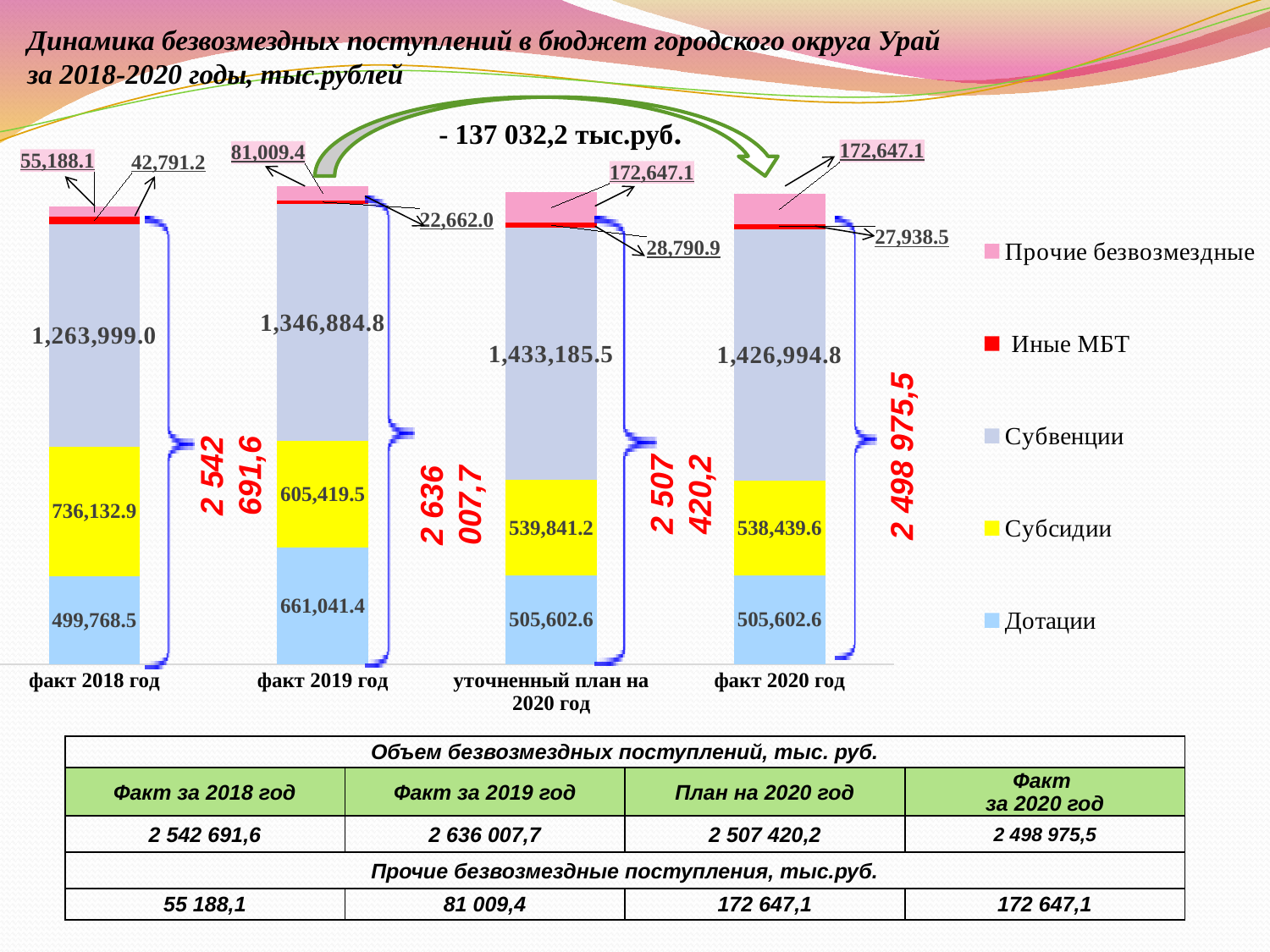
How many series does the chart legend list? 5 What kind of chart is shown on the slide? Stacked bar chart What is the value of Прочие безвозмездные for факт 2019 год? 81,009.4 How many categories (bars) are shown on the x axis of the chart? 4 Which is larger: Дотации for факт 2019 год or Дотации for факт 2018 год? факт 2019 год Which category has the lowest value for Иные МБТ? факт 2019 год What is the value of Субсидии for факт 2020 год? 538,439.6 What is the value of Субвенции for факт 2019 год? 1,346,884.8 What is the value of Иные МБТ for уточненный план на 2020 год? 28,790.9 Which category has the highest value for Субсидии? факт 2018 год What is the value of Дотации for факт 2018 год? 499,768.5 What is the total of the stacked bar for факт 2020 год? 2,671,622.6